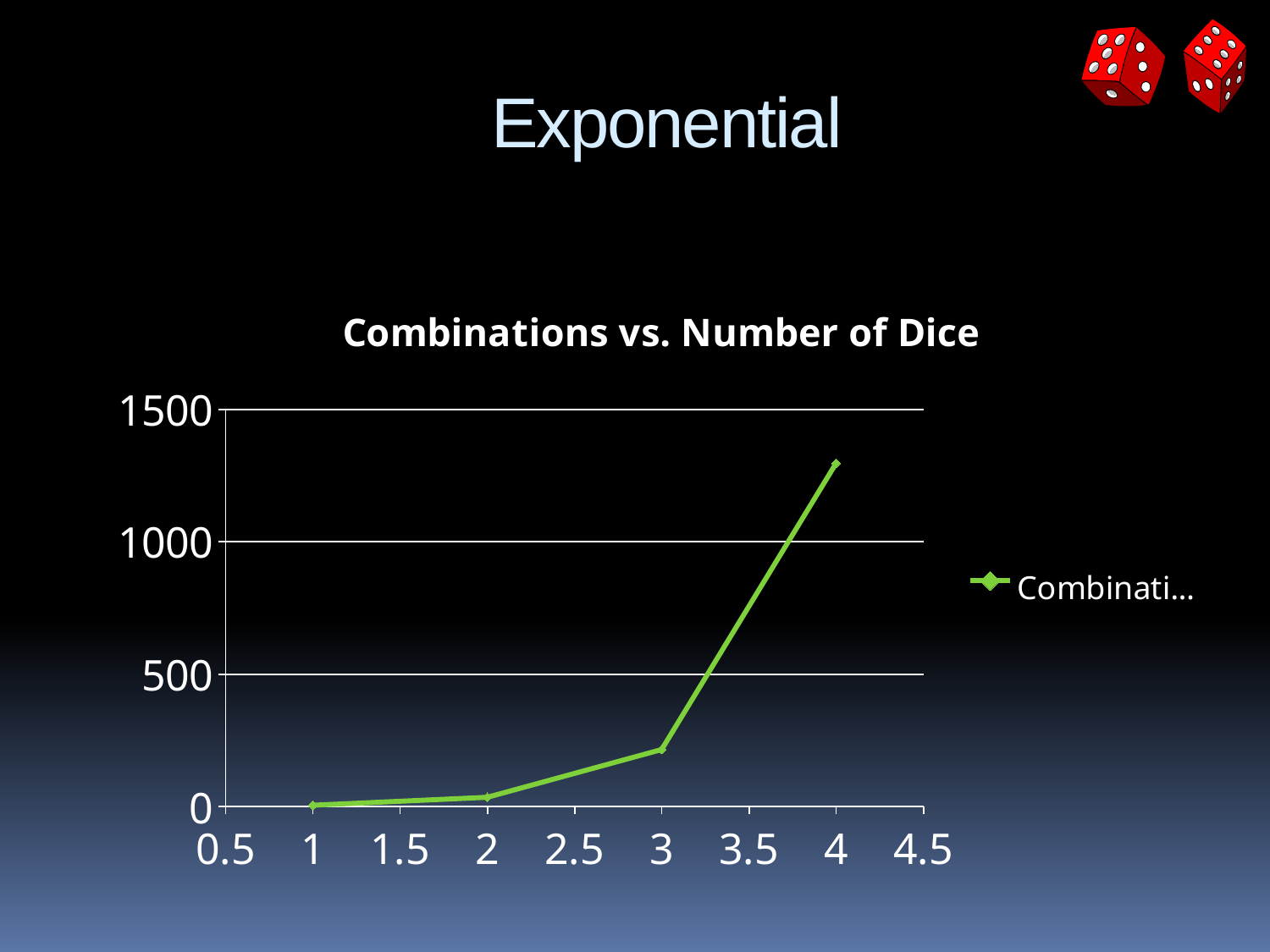
Which has the larger value, x = 3 or x = 4? 4 Is the value at x = 4 greater or less than 1000? greater What is the highest value shown on the y axis? 1500 Do the values rise or fall as the number of dice increases along the x axis? rise Is the value at x = 3 greater or less than 500? less How many series does the legend list? 1 Is the value at x = 2 greater or less than 500? less At which x value is the plotted value highest? 4 What is the title of the chart? Combinations vs. Number of Dice How many data points are plotted on the line? 4 What kind of chart is shown on the slide? line chart At which x value is the plotted value lowest? 1